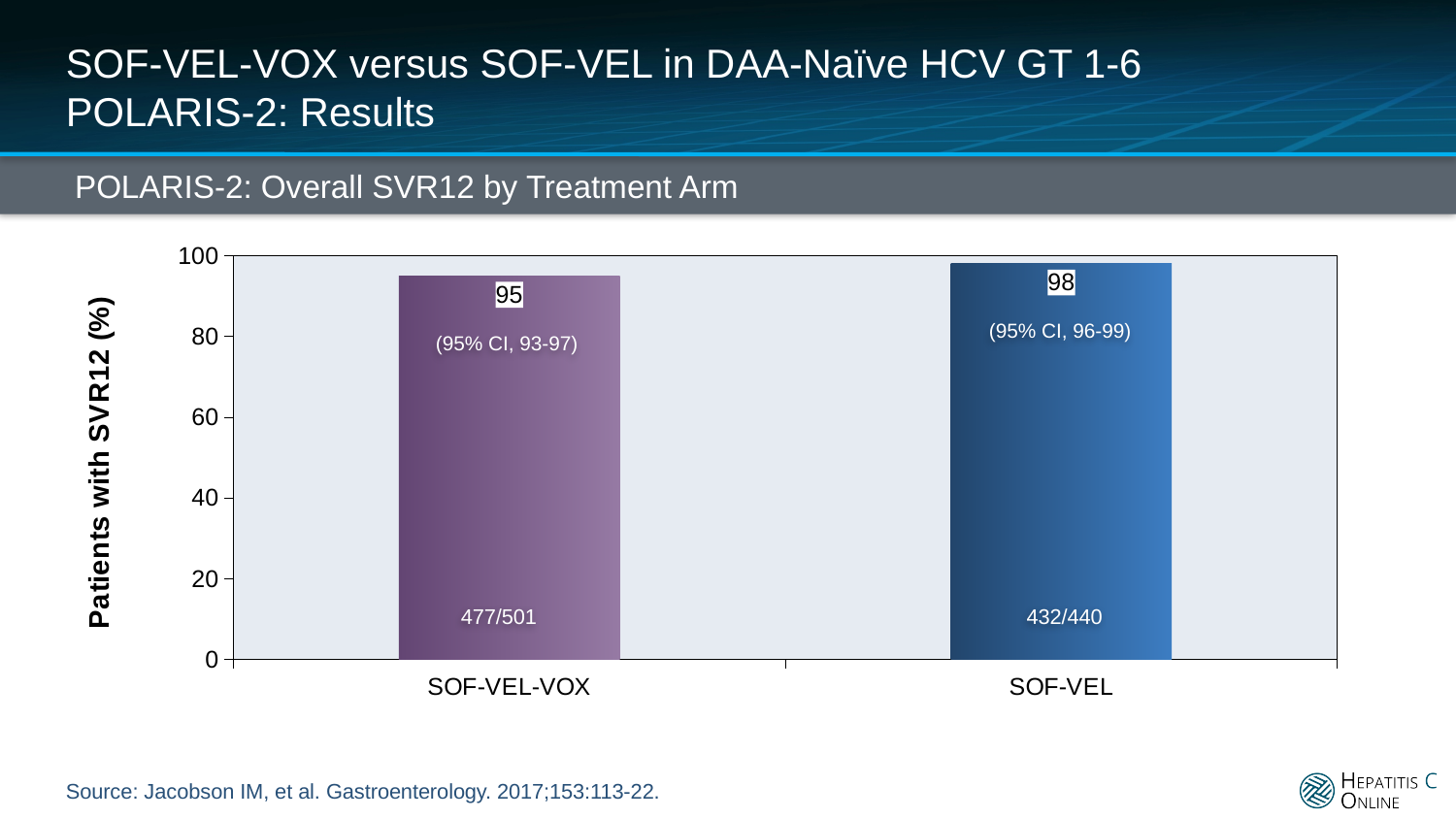
Which treatment arm has the higher SVR12 rate? SOF-VEL What kind of chart is shown on the slide? bar chart What is the SVR12 value for SOF-VEL? 98 What fraction of patients achieved SVR12 in the SOF-VEL arm? 432/440 Is the SVR12 value for SOF-VEL-VOX greater or less than 80? greater What is the 95% confidence interval shown for SOF-VEL? 96-99 What is the SVR12 value for SOF-VEL-VOX? 95 Which treatment arm has the lower SVR12 rate? SOF-VEL-VOX How many treatment arms are shown in the chart? 2 What is the 95% confidence interval shown for SOF-VEL-VOX? 93-97 What is the title of the chart? POLARIS-2: Overall SVR12 by Treatment Arm What is the difference in SVR12 between SOF-VEL and SOF-VEL-VOX? 3